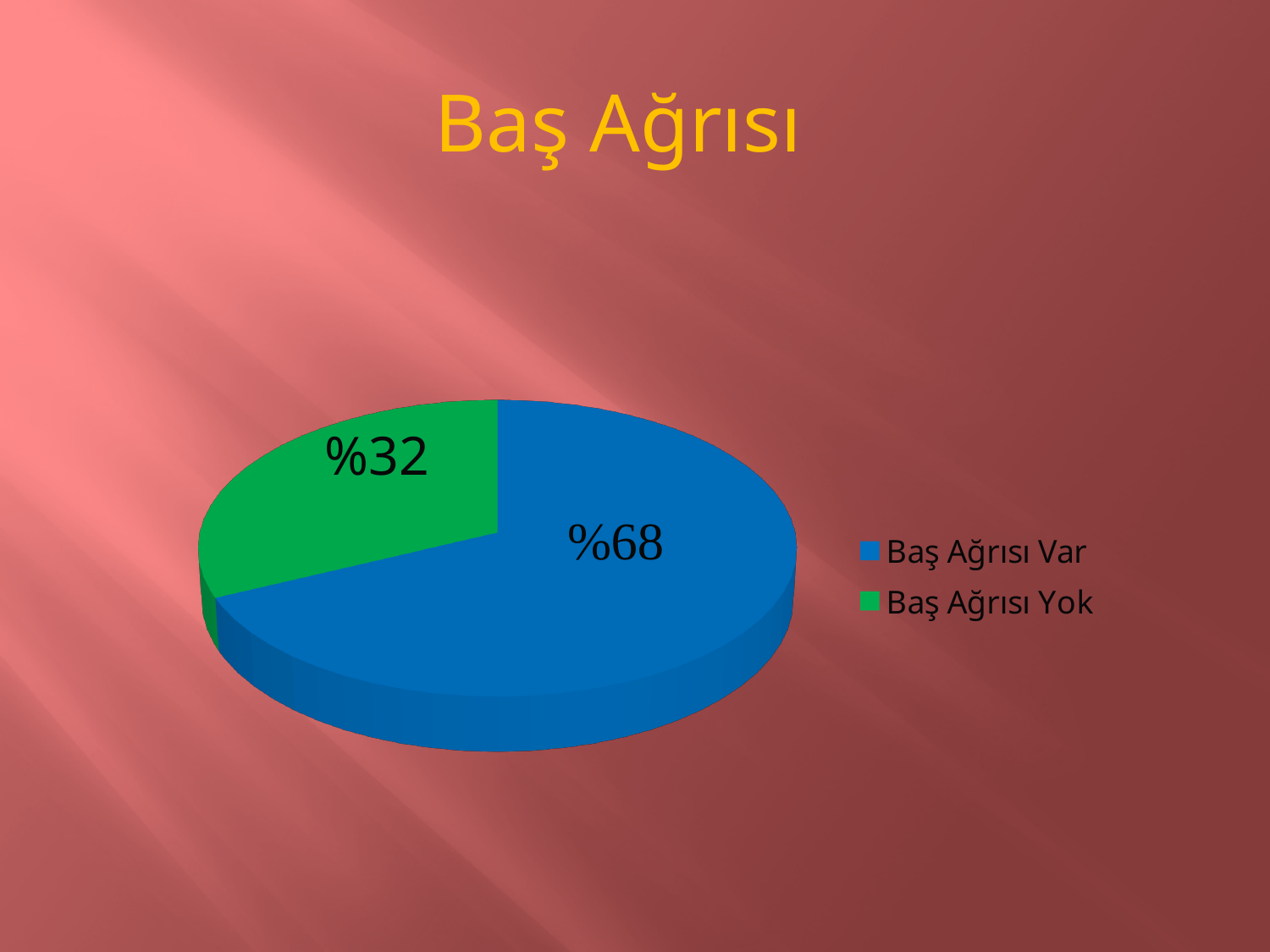
What is the value shown for "Baş Ağrısı Var"? %68 What is the title of the slide containing the chart? Baş Ağrısı What is the value shown for "Baş Ağrısı Yok"? %32 What colour is the slice for "Baş Ağrısı Yok"? green How many slices does the pie chart have? 2 How many entries does the legend list? 2 Which category has the largest slice of the pie? Baş Ağrısı Var What kind of chart is shown on the slide? pie chart What share of the pie does "Baş Ağrısı Yok" represent? %32 Which is larger, the slice for "Baş Ağrısı Var" or the slice for "Baş Ağrısı Yok"? Baş Ağrısı Var What is the difference between the values for "Baş Ağrısı Var" and "Baş Ağrısı Yok"? 36 percentage points Which category has the smallest slice of the pie? Baş Ağrısı Yok